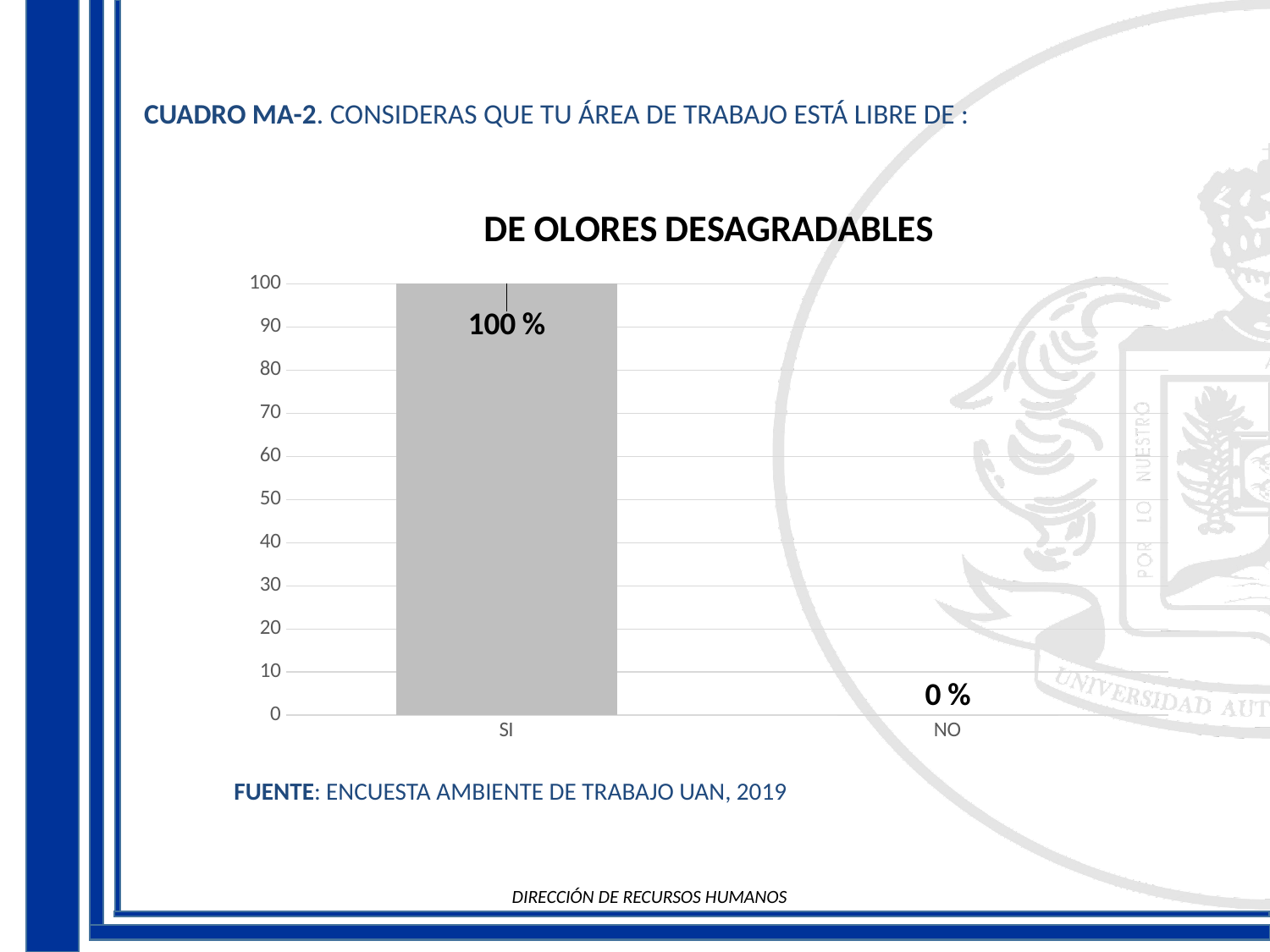
What is the maximum value shown on the y axis? 100 Which category has the highest value? SI What is the difference between the values for SI and NO? 100 % Which category has the lowest value? NO What is the value for SI? 100 % Which is larger, the value for SI or the value for NO? SI How many categories are shown on the x axis? 2 What is the value for NO? 0 % What is the title of the chart? DE OLORES DESAGRADABLES What kind of chart is shown? bar chart Is the value for SI greater or less than 50? greater